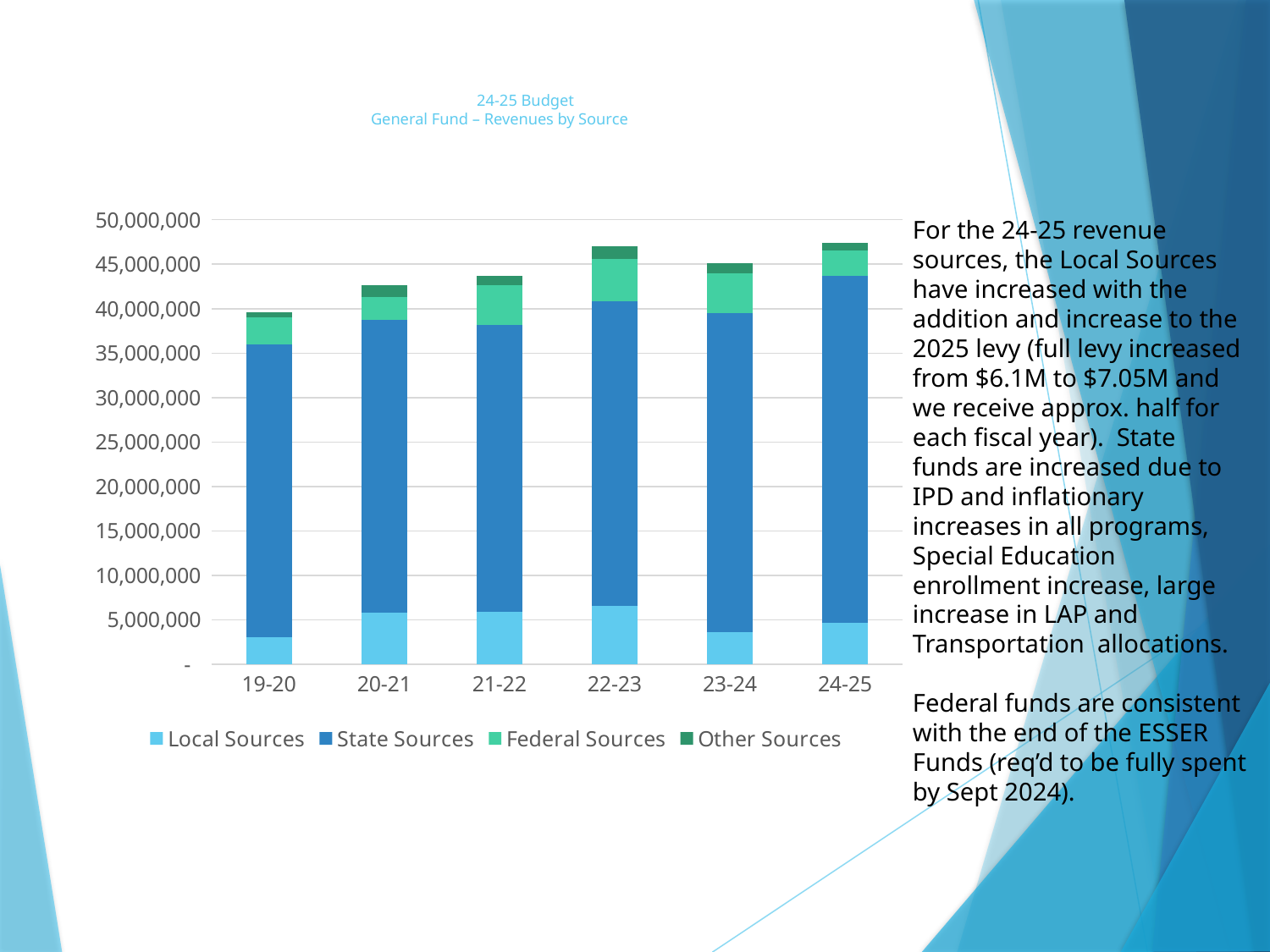
Which has the larger total revenue bar, 22-23 or 23-24? 22-23 Is the Local Sources value for 19-20 greater or less than 5,000,000? less Is the total revenue bar for 22-23 greater or less than 45,000,000? greater What kind of chart is shown on the slide? Stacked bar chart Which fiscal year has the lowest total revenue bar? 19-20 What is the title of the chart? 24-25 Budget General Fund – Revenues by Source How many fiscal years are shown on the x axis of the chart? 6 How many series does the chart's legend list? 4 Is the Local Sources value for 22-23 greater or less than 5,000,000? greater Which series forms the bottom segment of each stacked bar? Local Sources Do the total revenue bars rise or fall from 19-20 to 22-23? rise